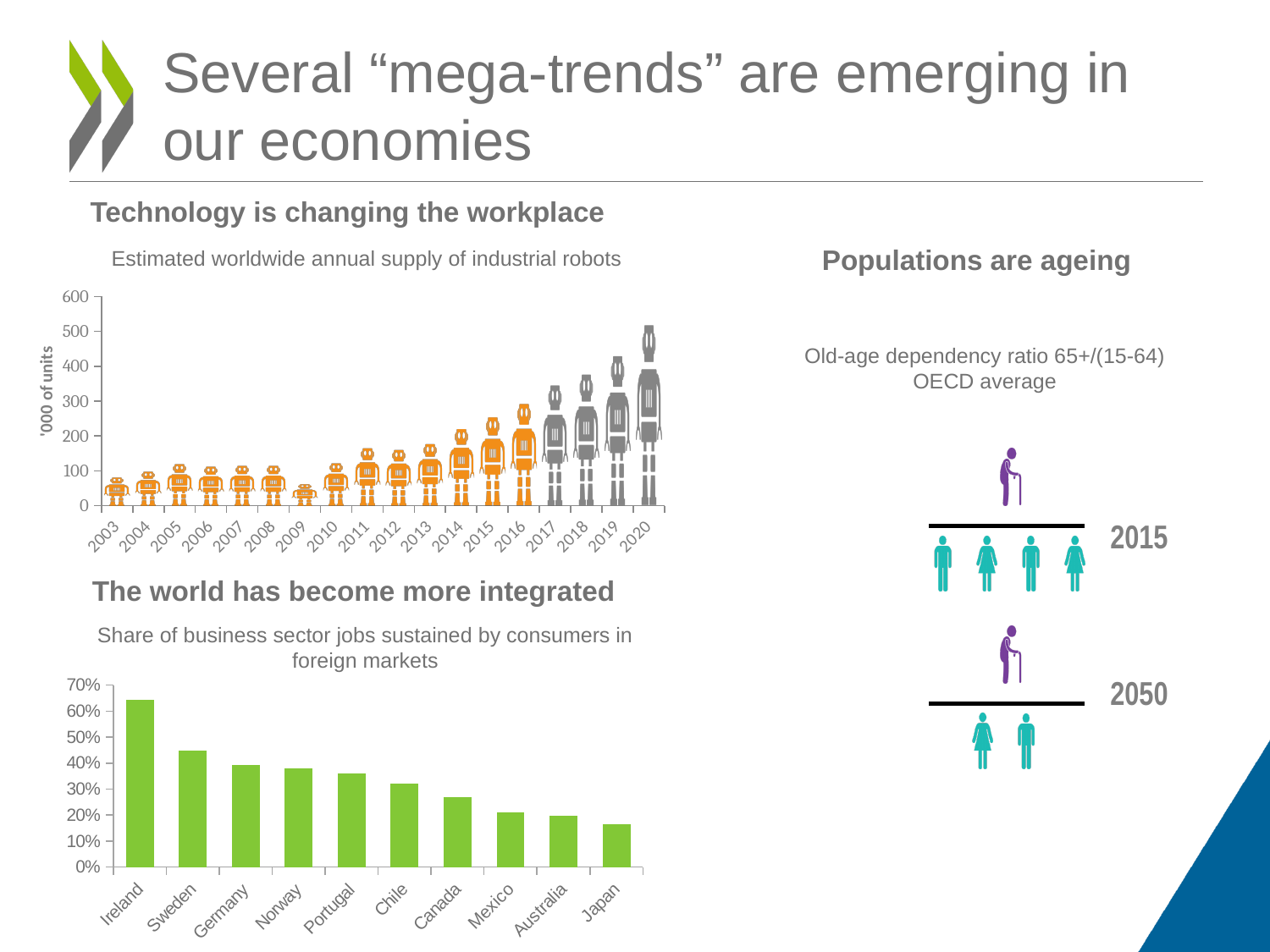
On the chart 'Share of business sector jobs sustained by consumers in foreign markets', how many countries are shown? 10 On the chart 'Share of business sector jobs sustained by consumers in foreign markets', which country has the lowest value? Japan On the chart 'Estimated worldwide annual supply of industrial robots', what unit is shown on the y axis? '000 of units On the chart 'Estimated worldwide annual supply of industrial robots', is the value for 2020 greater or less than 400? greater On the chart 'Estimated worldwide annual supply of industrial robots', do the values generally rise or fall from 2003 to 2020? rise On the chart 'Estimated worldwide annual supply of industrial robots', is the value for 2003 greater or less than 100? less On the chart 'Estimated worldwide annual supply of industrial robots', which year has the lowest value? 2009 On the chart 'Share of business sector jobs sustained by consumers in foreign markets', which country has the highest value? Ireland On the chart 'Estimated worldwide annual supply of industrial robots', which year has the highest value? 2020 On the chart 'Share of business sector jobs sustained by consumers in foreign markets', is the value for Ireland greater or less than 60%? greater On the chart 'Share of business sector jobs sustained by consumers in foreign markets', which is larger, the value for Chile or the value for Canada? Chile On the chart 'Estimated worldwide annual supply of industrial robots', how many years are shown on the x axis? 18